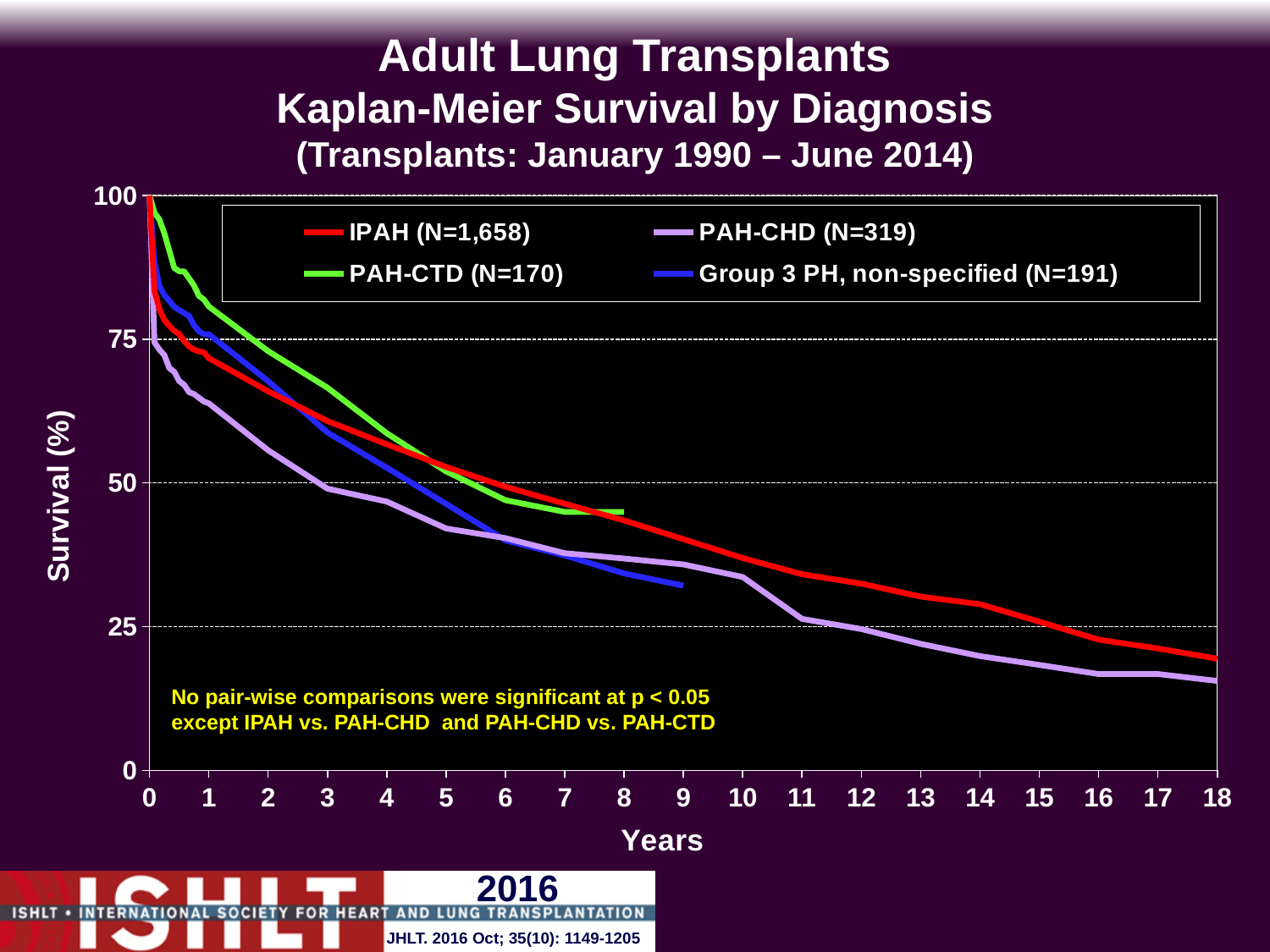
Is the survival value for PAH-CTD at 3 years greater or less than 50? greater Is the survival value for Group 3 PH, non-specified at 9 years greater or less than 25? greater Is the survival value for PAH-CHD at 18 years greater or less than 25? less What is the sample size (N) shown in the legend for IPAH? 1,658 At 15 years, which has higher survival: IPAH or PAH-CHD? IPAH How many series does the legend list? 4 At 2 years, which diagnosis group has the lowest survival? PAH-CHD Do the survival curves rise or fall as years increase? Fall What is the sample size (N) shown in the legend for PAH-CHD? 319 At 2 years, which diagnosis group has the highest survival? PAH-CTD What kind of chart is shown on the slide? Line chart